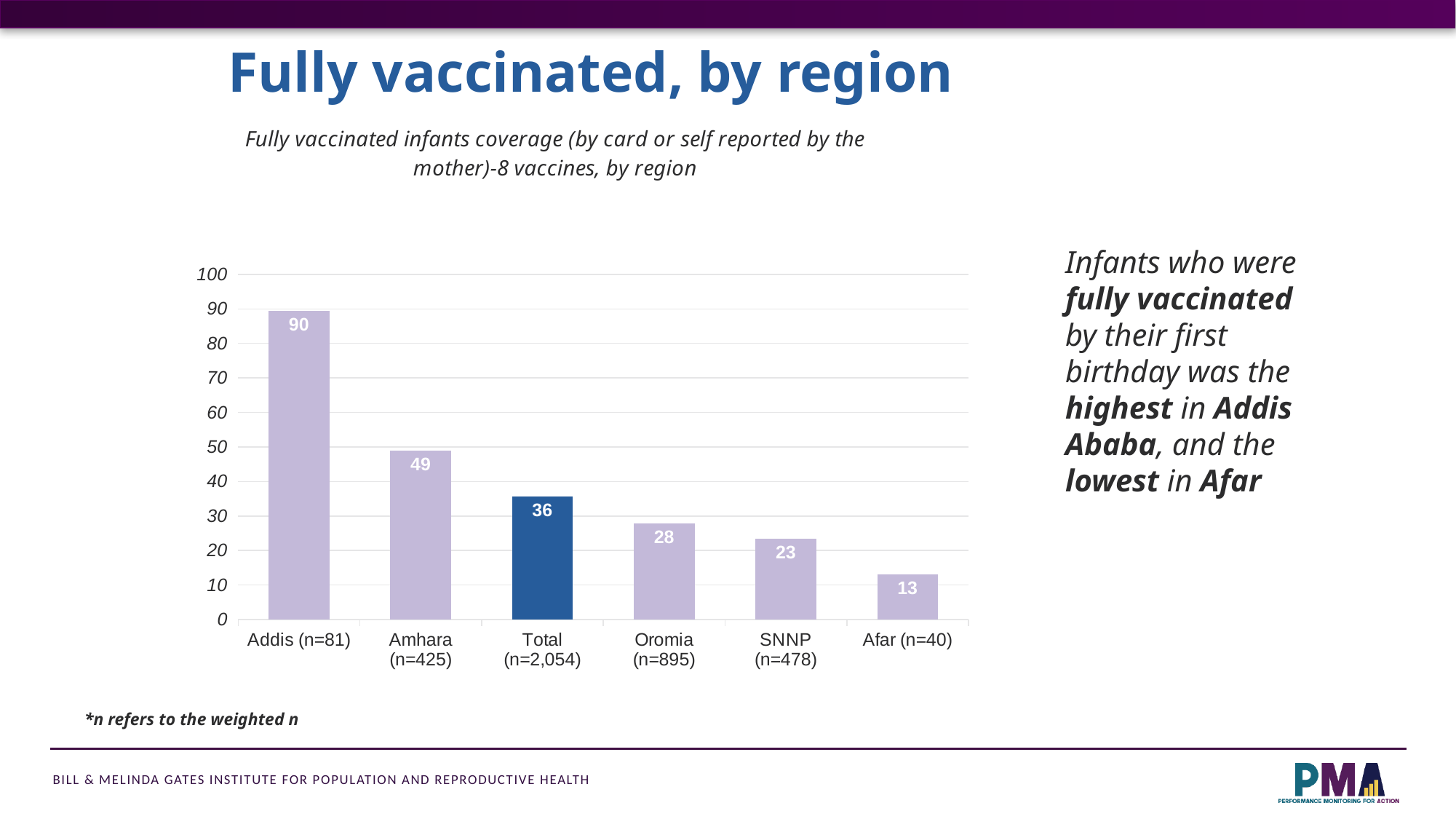
What is the difference between the values for Oromia (n=895) and SNNP (n=478)? 5 What is the title of the chart? Fully vaccinated infants coverage (by card or self reported by the mother)-8 vaccines, by region What is the value for Total (n=2,054)? 36 What is the value for Afar (n=40)? 13 What is the value for Addis (n=81)? 90 Which category has the lowest value? Afar (n=40) Which category has the highest value? Addis (n=81) What kind of chart is shown on the slide? Bar chart How many categories are shown on the x axis? 6 What is the difference between the values for Addis (n=81) and Amhara (n=425)? 41 What is the value for Amhara (n=425)? 49 Which is larger, the value for Oromia (n=895) or the value for SNNP (n=478)? Oromia (n=895)